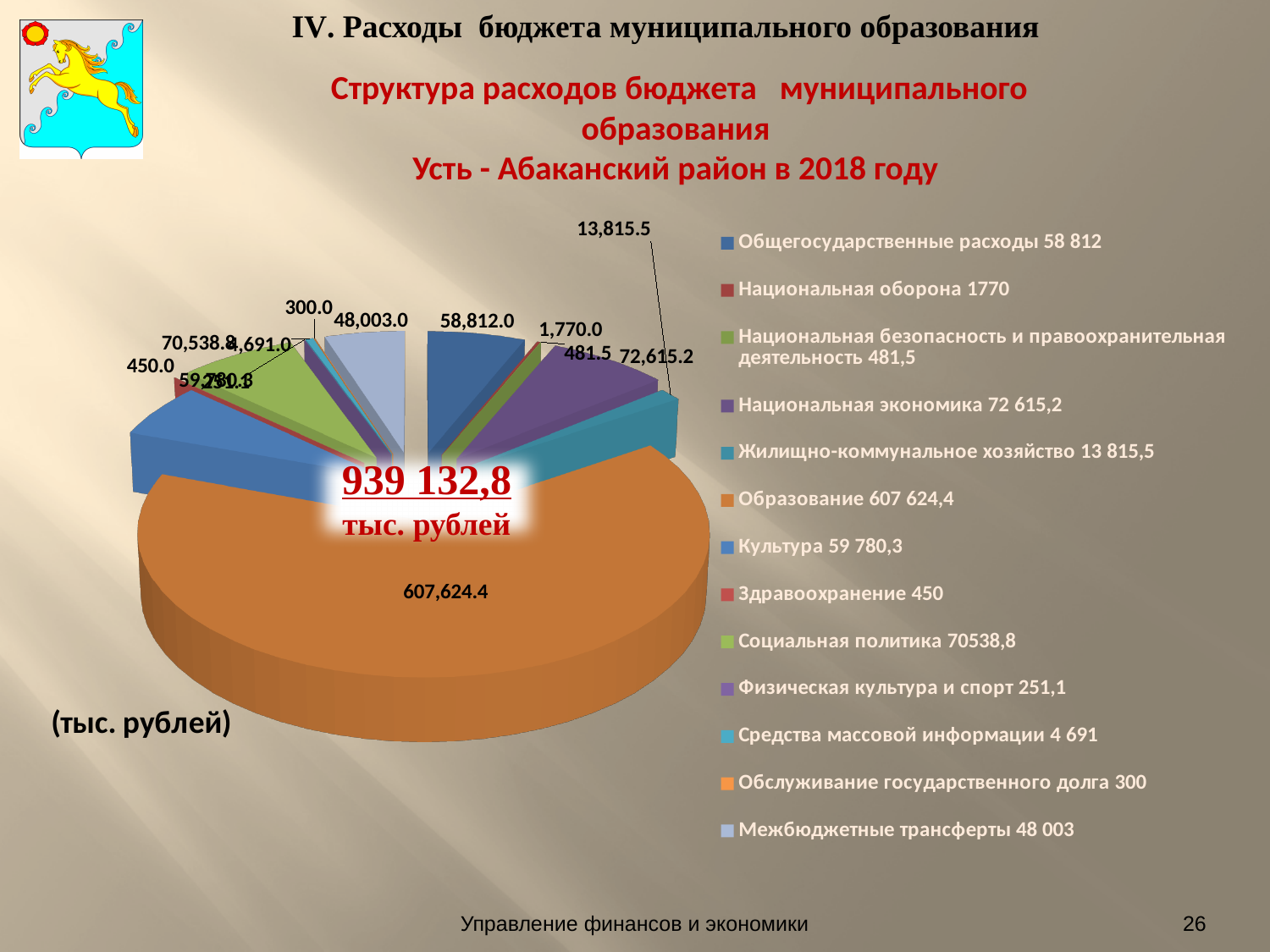
What is the value for Национальная экономика on the pie chart? 72,615.2 What type of chart is shown on the slide? pie chart Which category has the largest slice of the pie chart? Образование What is the value for Образование on the pie chart? 607,624.4 Which is larger: Национальная экономика or Общегосударственные расходы? Национальная экономика What is the value for Межбюджетные трансферты on the pie chart? 48,003.0 Which category has the smallest value in the pie chart? Физическая культура и спорт How many categories does the legend of the pie chart list? 13 What is the value for Жилищно-коммунальное хозяйство on the pie chart? 13,815.5 What is the value for Общегосударственные расходы on the pie chart? 58,812.0 What is the difference between the values for Национальная экономика (72,615.2) and Общегосударственные расходы (58,812.0)? 13,803.2 What total amount is printed in the centre of the pie chart? 939 132,8 тыс. рублей